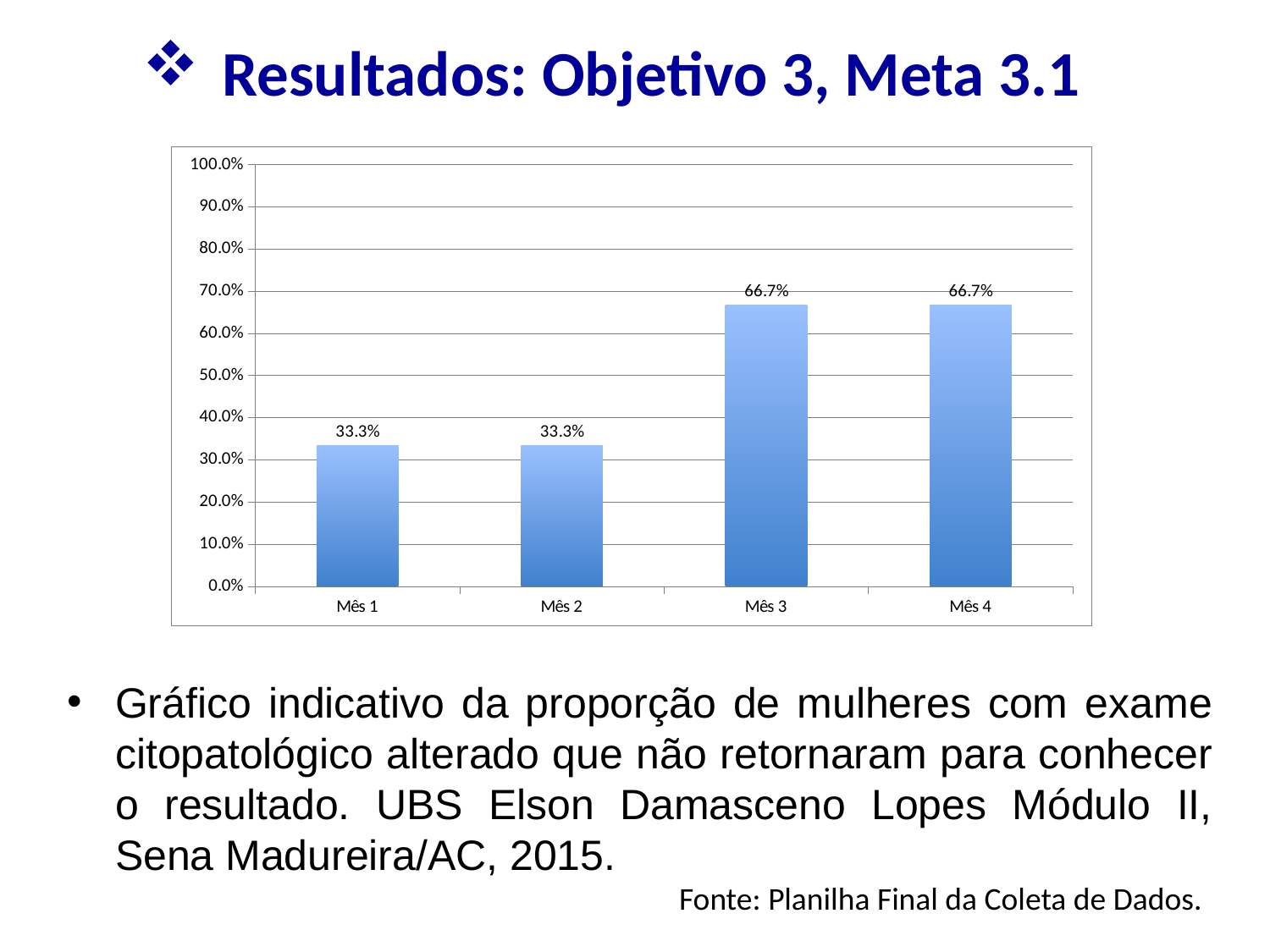
What is the label of the first category on the x axis? Mês 1 Do the values rise or fall from Mês 1 to Mês 4? rise Which is larger, the value for Mês 1 or the value for Mês 4? Mês 4 What is the value for Mês 3? 66.7% What is the highest value shown on the y axis? 100.0% How many categories are shown on the x axis? 4 What is the difference between the values for Mês 3 and Mês 2? 33.4% What is the value for Mês 4? 66.7% What is the value for Mês 1? 33.3% Is the value for Mês 3 greater or less than 60.0%? greater Is the value for Mês 2 greater or less than 50.0%? less What kind of chart is shown on the slide? bar chart